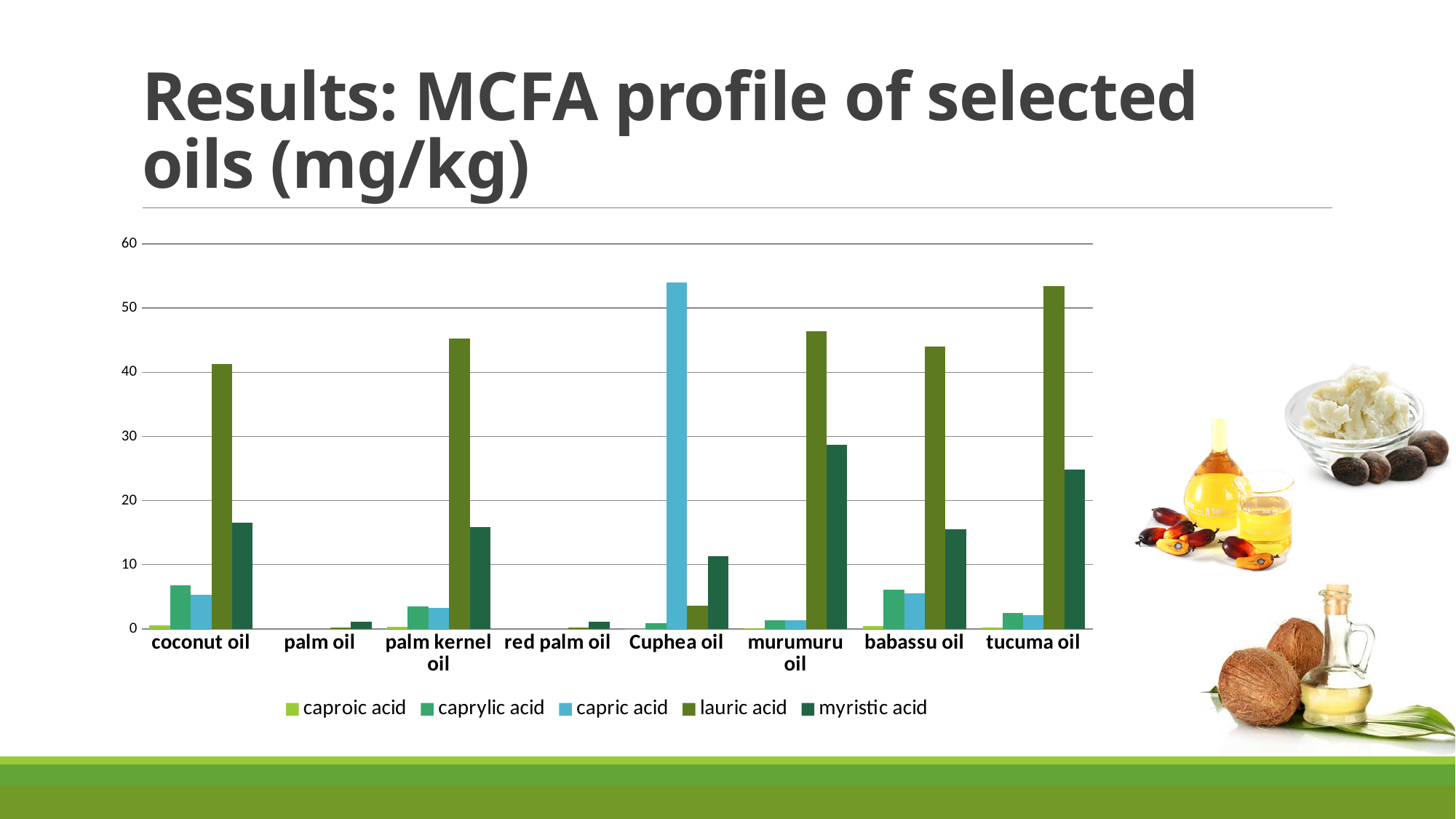
Is the myristic acid value for murumuru oil greater or less than 20? greater How many oils are shown on the x axis of the chart? 8 How many series does the legend list? 5 Which series is shown in light blue in the legend? capric acid Which oil has the highest myristic acid value? murumuru oil Which is larger, the lauric acid value for coconut oil or for palm kernel oil? palm kernel oil Which oil has the highest capric acid value? Cuphea oil Is the capric acid value for Cuphea oil greater or less than 50? greater Which oil has the highest lauric acid value? tucuma oil What kind of chart is shown on the slide? bar chart Is the lauric acid value for coconut oil greater or less than 50? less